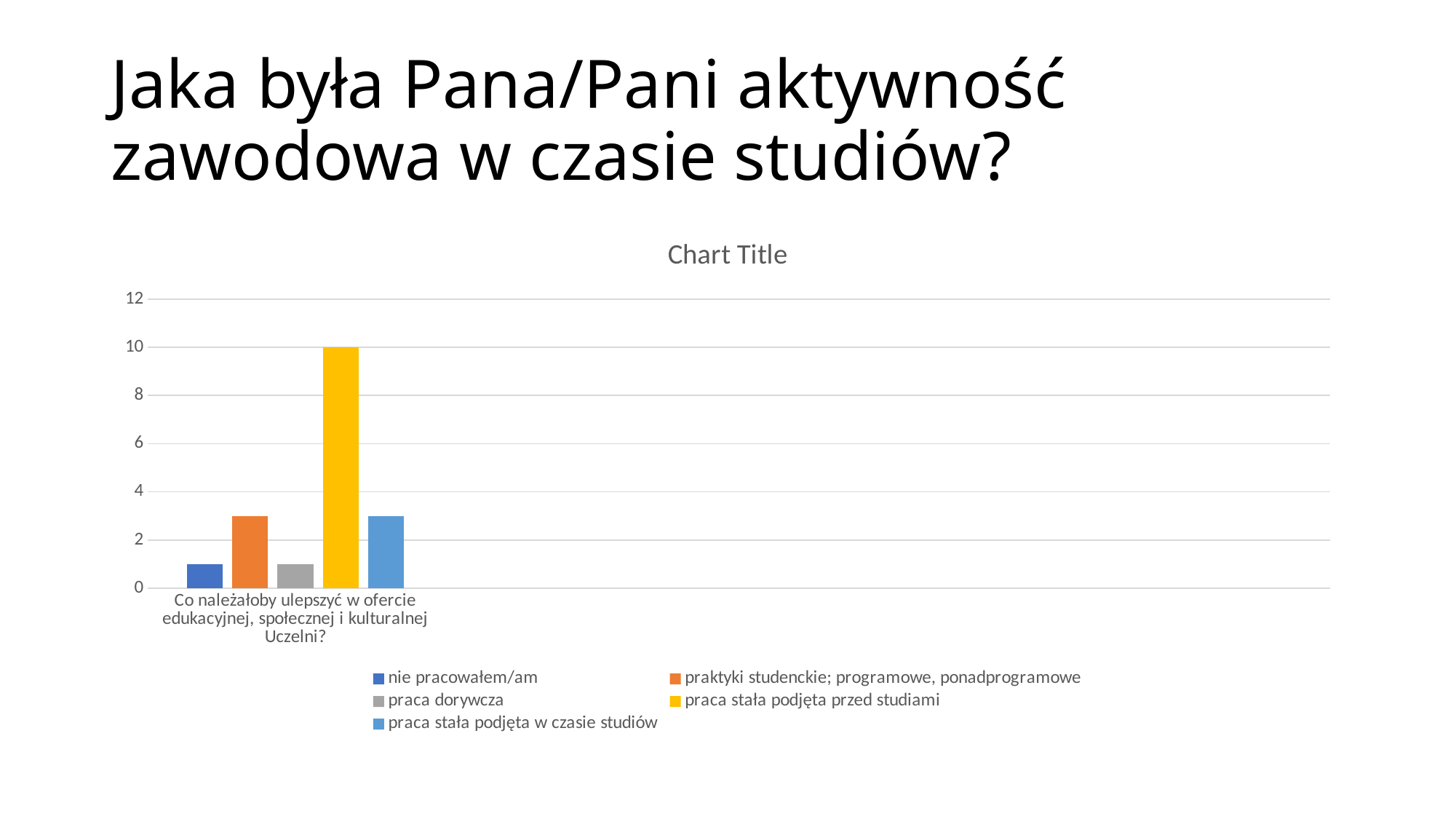
Is the value for 'praca stała podjęta w czasie studiów' greater or less than 2? greater Which is larger: the value for 'praca stała podjęta przed studiami' or the value for 'praca dorywcza'? praca stała podjęta przed studiami Is the value for 'praktyki studenckie; programowe, ponadprogramowe' greater or less than 4? less How many categories are shown on the x axis? 1 What is the value for 'praca stała podjęta przed studiami'? 10 Is the value for 'nie pracowałem/am' greater or less than 2? less How many series does the legend list? 5 Which is larger: the value for 'praktyki studenckie; programowe, ponadprogramowe' or the value for 'nie pracowałem/am'? praktyki studenckie; programowe, ponadprogramowe Which series has the highest value? praca stała podjęta przed studiami What is the title shown above the chart? Chart Title What type of chart is shown on the slide? bar chart